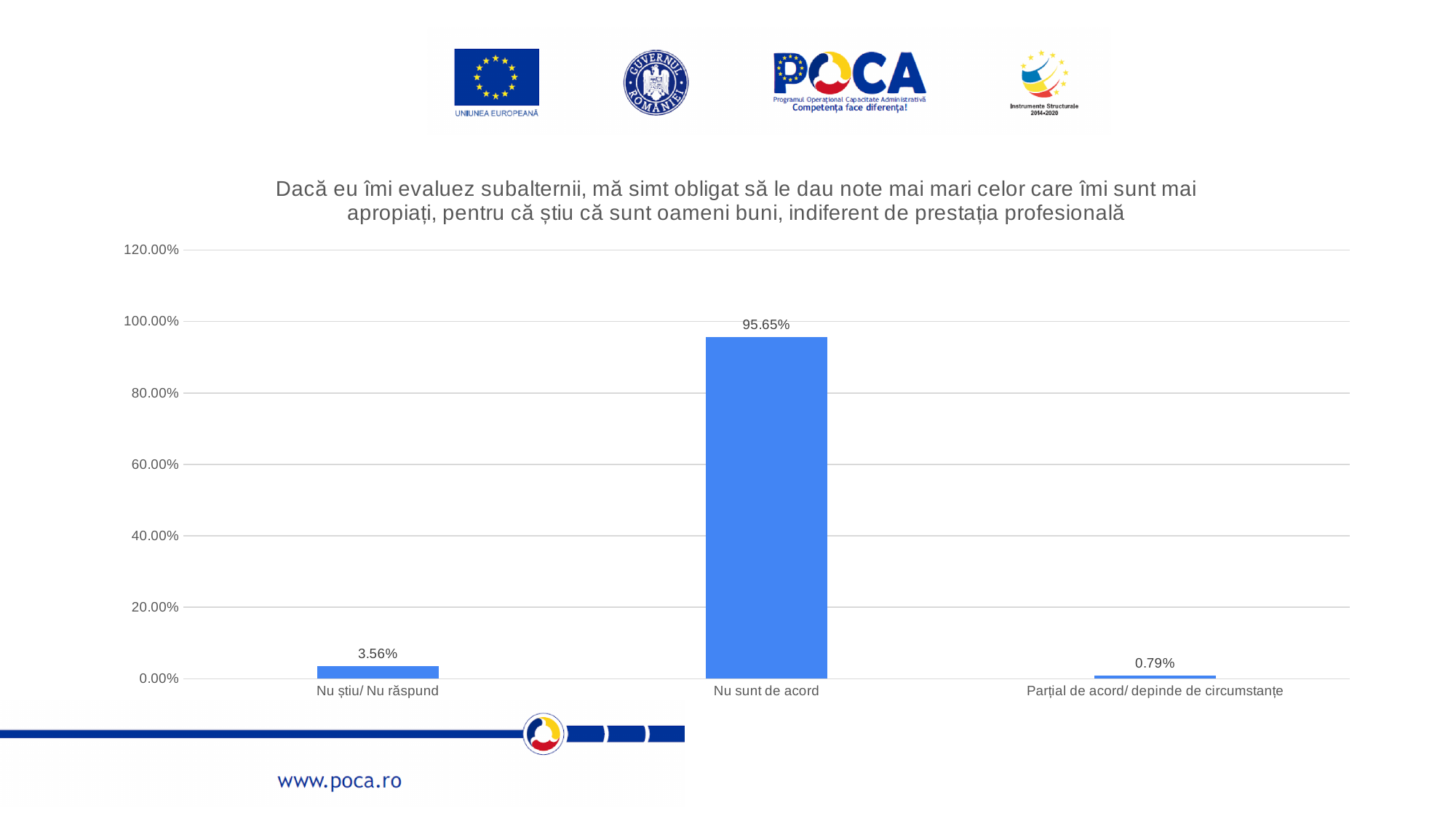
What is the value for "Nu sunt de acord"? 95.65% What kind of chart is shown on the slide? bar chart What is the highest value shown on the vertical axis? 120.00% What is the difference between the values for "Nu știu/ Nu răspund" and "Parțial de acord/ depinde de circumstanțe"? 2.77% Which category has the highest value? Nu sunt de acord What is the value for "Parțial de acord/ depinde de circumstanțe"? 0.79% How many categories are shown on the x axis? 3 Is the value for "Nu sunt de acord" greater or less than 80.00%? greater What is the difference between the values for "Nu sunt de acord" and "Nu știu/ Nu răspund"? 92.09% Which category has the lowest value? Parțial de acord/ depinde de circumstanțe Which is larger, the value for "Nu știu/ Nu răspund" or the value for "Parțial de acord/ depinde de circumstanțe"? Nu știu/ Nu răspund What is the value for "Nu știu/ Nu răspund"? 3.56%